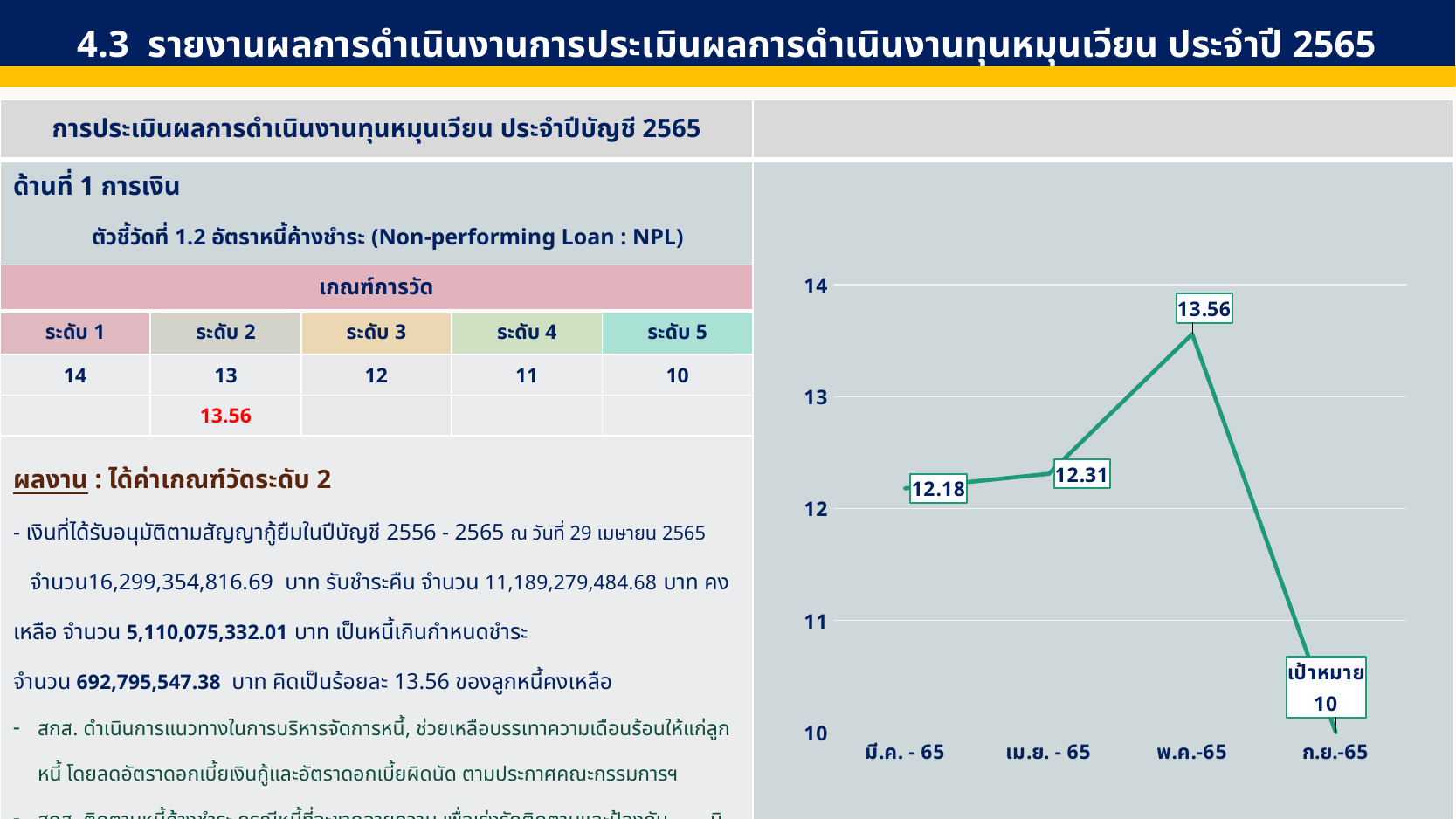
Which is larger, the value for มี.ค. - 65 or the value for เม.ย. - 65? เม.ย. - 65 What is the value plotted for ก.ย.-65? 10 Which month has the lowest plotted value? ก.ย.-65 What label is shown next to the last data point on the line chart? เป้าหมาย 10 Which month has the highest plotted value? พ.ค.-65 What is the value plotted for เม.ย. - 65? 12.31 What is the value plotted for พ.ค.-65? 13.56 What is the difference between the values for พ.ค.-65 and เม.ย. - 65? 1.25 What is the value plotted for มี.ค. - 65? 12.18 What kind of chart is shown on the right side of the slide? line chart How many data points are plotted on the line chart? 4 Is the value for พ.ค.-65 greater or less than 13? greater